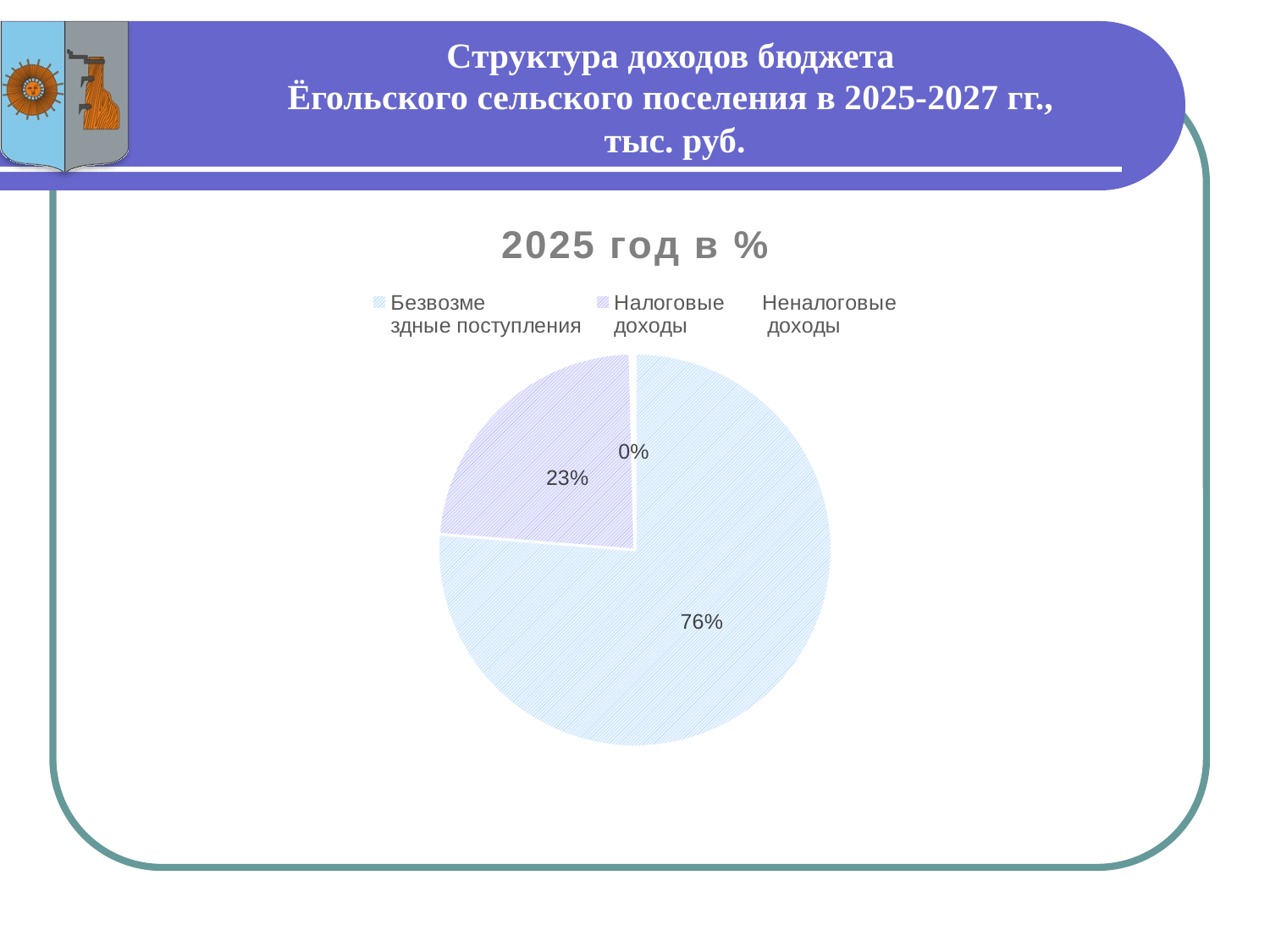
Which category has the smallest slice of the pie? Неналоговые доходы What is the title of the chart? 2025 год в % How many slices have a data label printed on the pie chart? 3 What share of the pie does Налоговые доходы have? 23% How many categories does the legend of the pie chart list? 3 Which is larger: the share of Налоговые доходы or the share of Неналоговые доходы? Налоговые доходы Which category has the largest slice of the pie? Безвозмездные поступления What is the difference in percentage points between Безвозмездные поступления and Налоговые доходы? 53 What share of the pie does Неналоговые доходы have? 0% Which is larger: the share of Безвозмездные поступления or the share of Налоговые доходы? Безвозмездные поступления What share of the pie does Безвозмездные поступления have? 76% What kind of chart is shown on the slide? pie chart